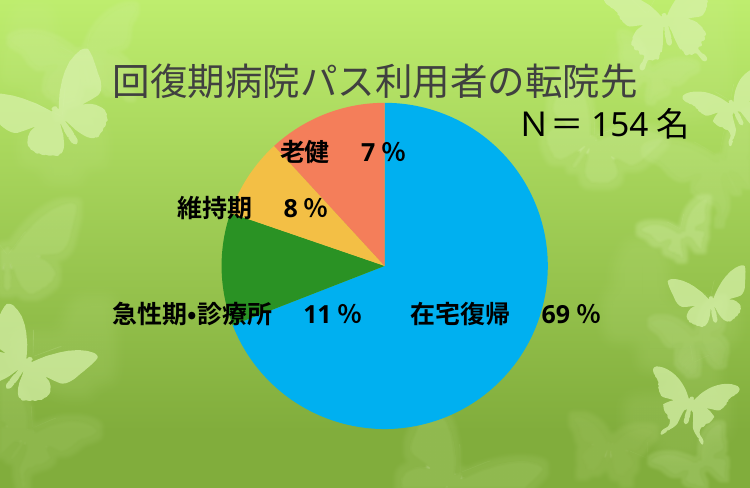
What is the share for 急性期•診療所? 11％ What kind of chart is shown on the slide? pie chart How many slices does the pie chart have? 4 Which is larger, the share for 維持期 or the share for 老健? 維持期 What is the share for 維持期? 8％ What is the difference in percentage points between 在宅復帰 and 急性期•診療所? 58 What is the share for 老健? 7％ What is the share for 在宅復帰? 69％ What is the sample size (N) shown on the slide? 154名 What is the title of the chart? 回復期病院パス利用者の転院先 Which category has the largest share of the pie? 在宅復帰 Which category has the smallest share of the pie? 老健